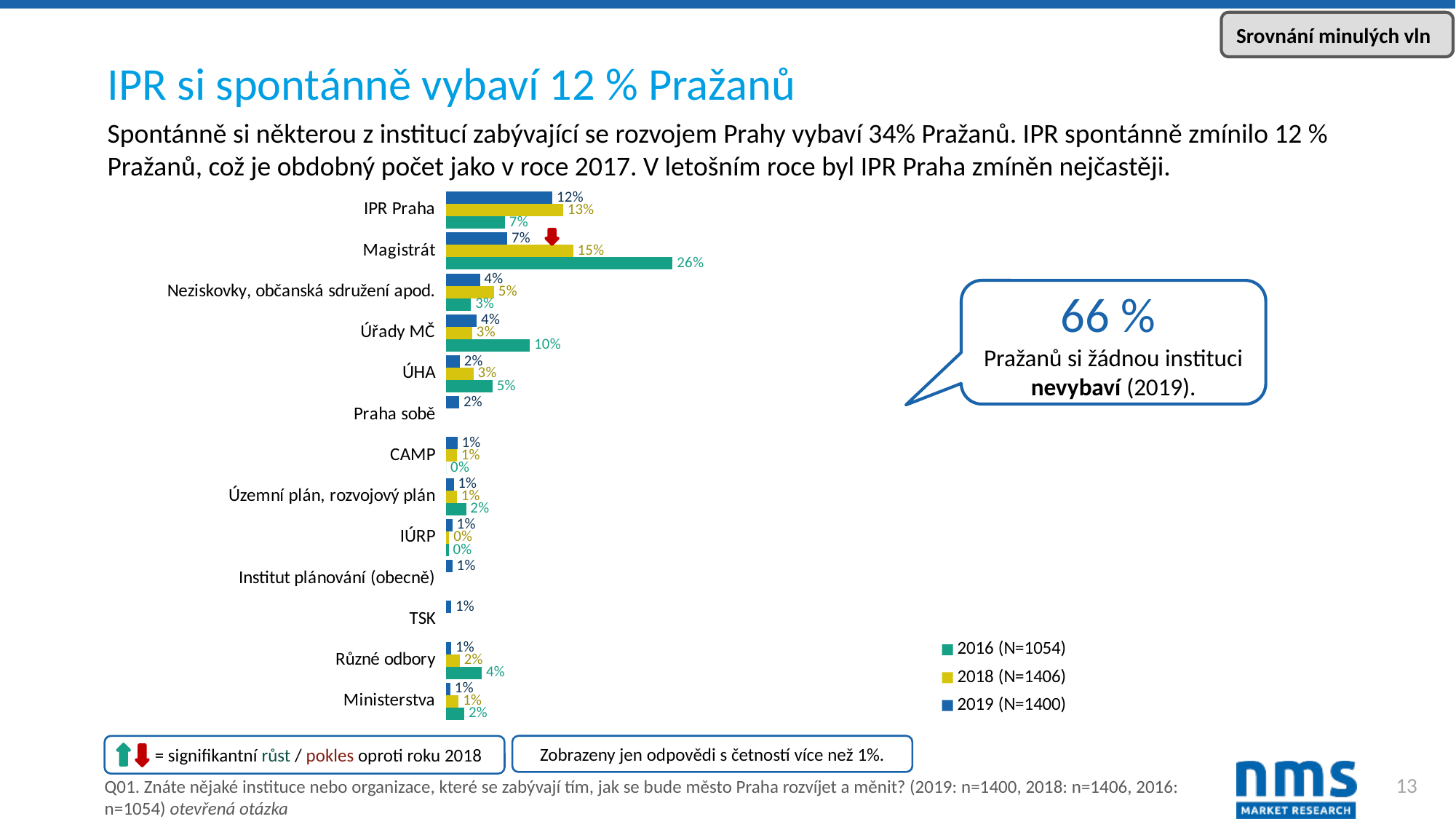
What is the 2016 value for Magistrát? 26% Which is larger for Úřady MČ: the 2016 value or the 2019 value? 2016 What is the 2018 value for Úřady MČ? 3% Which category has the highest 2019 value? IPR Praha Which series is shown in yellow in the legend? 2018 (N=1406) What is the 2019 value for IPR Praha? 12% What is the difference between the 2018 and 2019 values for IPR Praha? 1% How many categories are shown on the chart? 13 How many series does the legend list? 3 What is the difference between the 2016 and 2019 values for Magistrát? 19% Which category has the highest 2016 value? Magistrát What kind of chart is shown on the slide? bar chart